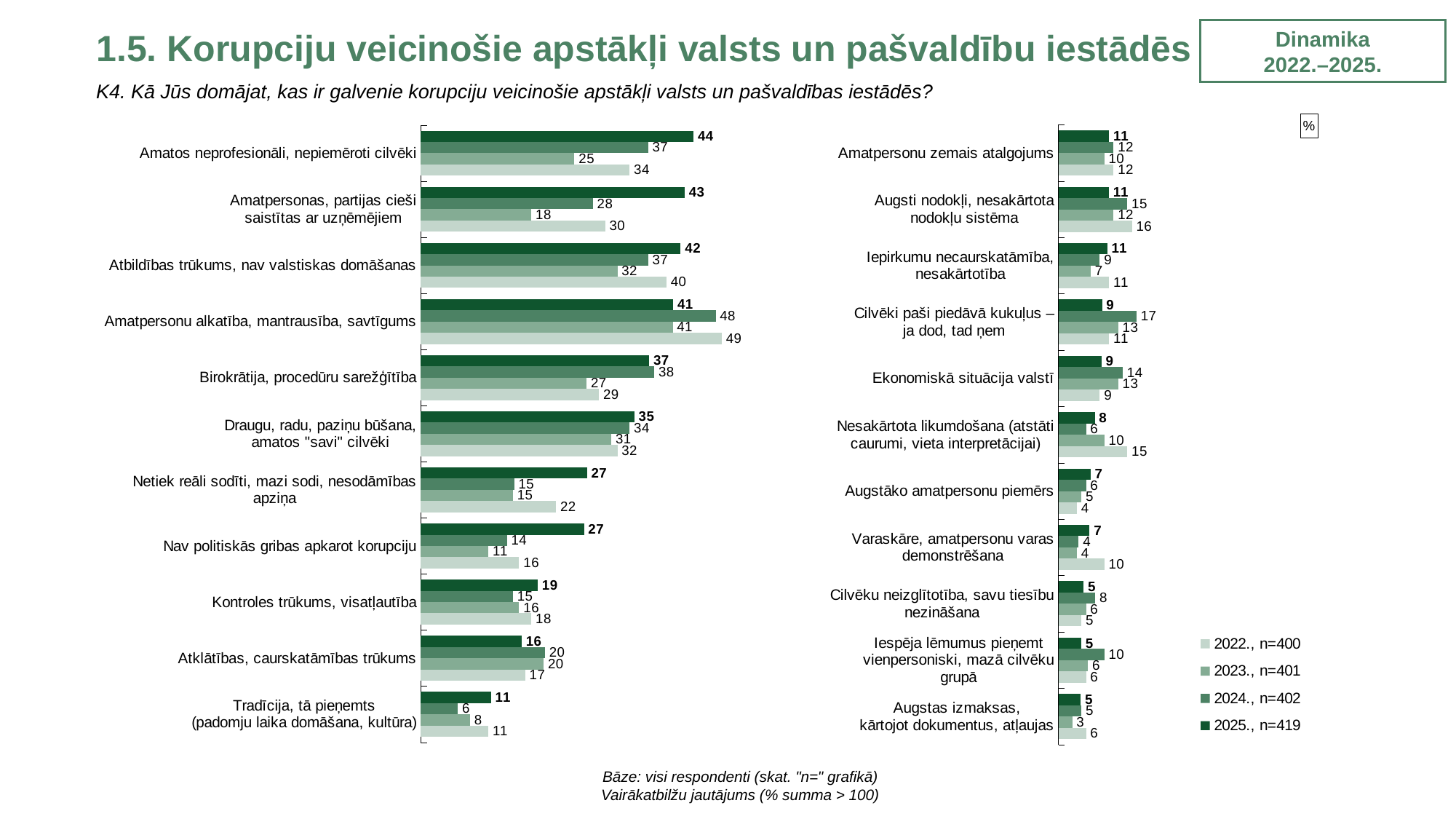
On the left chart, which is larger for "Birokrātija, procedūru sarežģītība": the 2025 value or the 2024 value? 2024 On the left chart, what is the difference between the 2025 and 2024 values for "Nav politiskās gribas apkarot korupciju"? 13 What type of chart is used on this slide? Bar chart According to the legend, what is the sample size (n) for 2025? 419 On the right chart, what is the difference between the 2022 and 2025 values for "Nesakārtota likumdošana (atstāti caurumi, vieta interpretācijai)"? 7 On the left chart, what is the 2025 value for "Amatos neprofesionāli, nepiemēroti cilvēki"? 44 How many categories are shown on the left chart? 11 On the right chart, what is the 2024 value for "Cilvēki paši piedāvā kukuļus – ja dod, tad ņem"? 17 On the left chart, what is the 2022 value for "Amatpersonu alkatība, mantrausība, savtīgums"? 49 On the left chart, which category has the highest 2025 value? Amatos neprofesionāli, nepiemēroti cilvēki How many series does the legend list? 4 On the right chart, which category has the lowest 2023 value? Augstas izmaksas, kārtojot dokumentus, atļaujas